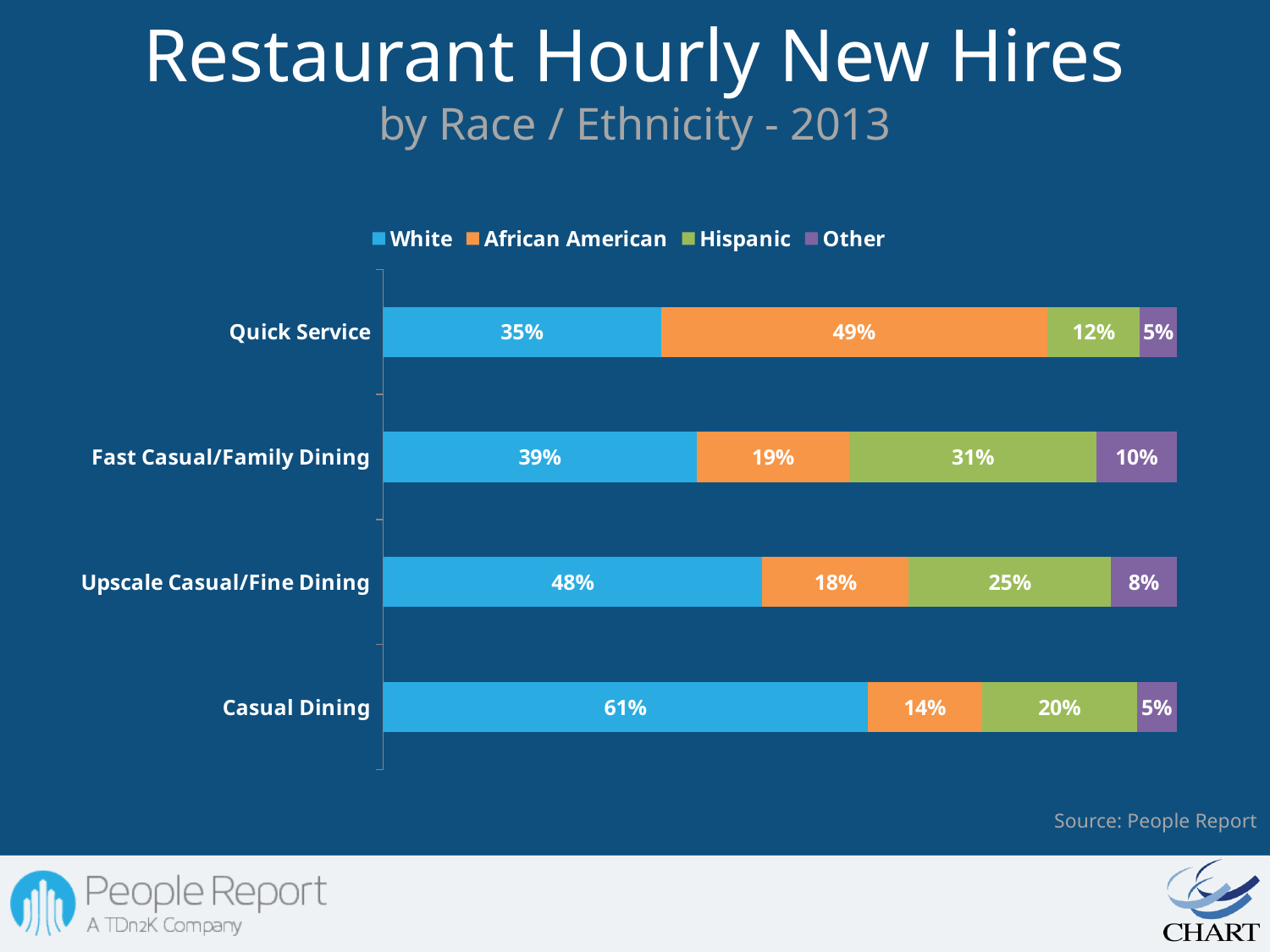
What kind of chart is shown on the slide? Stacked bar chart What is the White share of hourly new hires for Casual Dining? 61% Which is larger: the African American share for Fast Casual/Family Dining or for Upscale Casual/Fine Dining? Fast Casual/Family Dining How many restaurant segments are shown on the chart? 4 Which segment has the highest White share of hourly new hires? Casual Dining What is the total of the stacked bar for Fast Casual/Family Dining? 99% What is the Hispanic share of hourly new hires for Fast Casual/Family Dining? 31% What is the difference between the White share for Casual Dining and the White share for Quick Service? 26% Which segment has the lowest Hispanic share of hourly new hires? Quick Service What percentage of Quick Service hourly new hires are African American? 49% How many series does the legend list? 4 What is the Other share of hourly new hires for Upscale Casual/Fine Dining? 8%